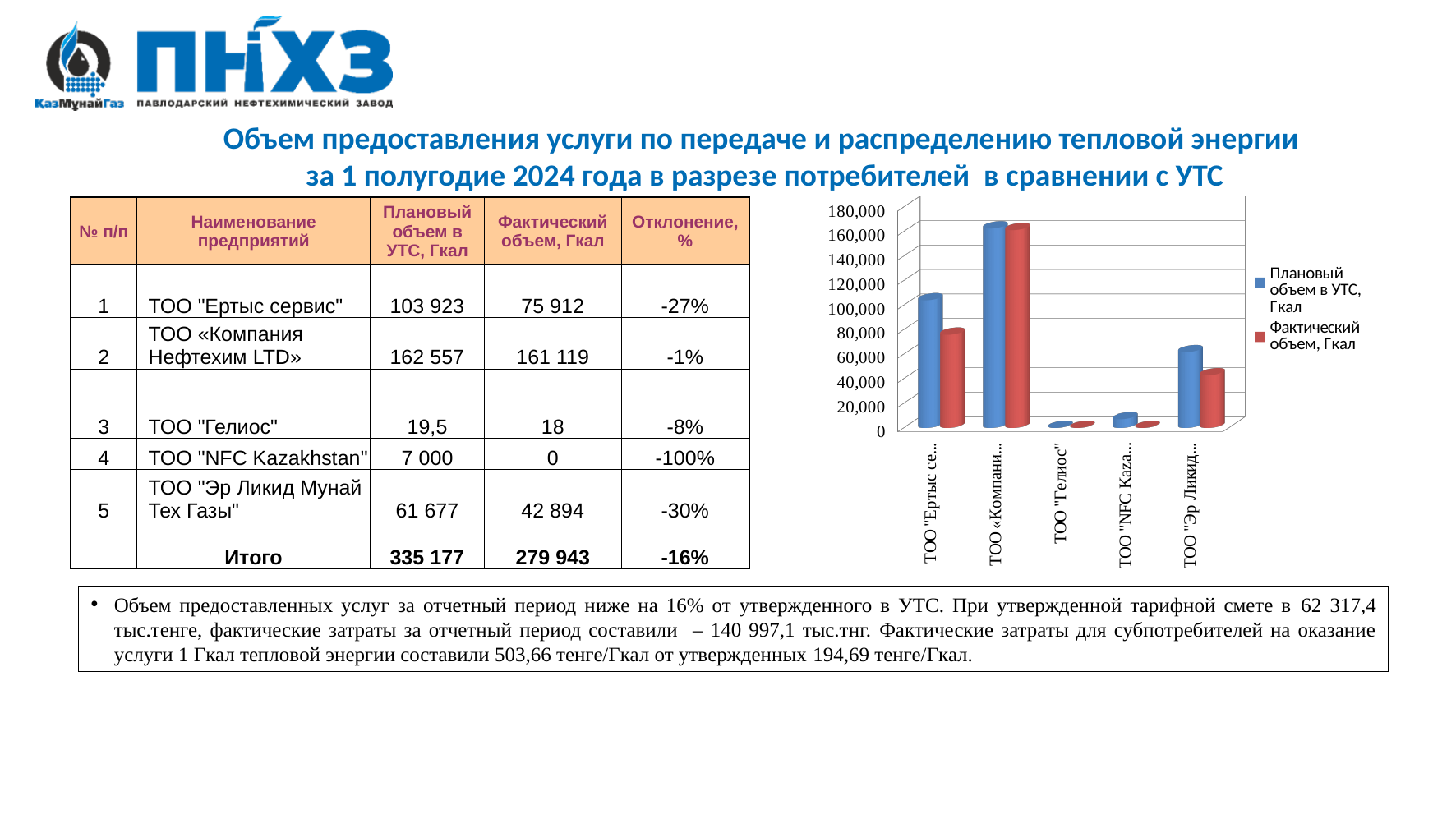
Which company has the lowest actual volume (Фактический объем) in the chart? ТОО "NFC Kazakhstan" Is the actual volume bar for ТОО "Эр Ликид Мунай Тех Газы" greater or less than 60,000? less How many series does the chart legend list? 2 According to the table on the slide, what is the planned volume in УТС for ТОО "Гелиос", Гкал? 19,5 How many companies (categories) are plotted on the x axis of the chart? 5 Which company has the highest planned volume (Плановый объем в УТС) in the chart? ТОО «Компания Нефтехим LTD» According to the table on the slide, what is the actual volume for ТОО "Эр Ликид Мунай Тех Газы", Гкал? 42 894 Using the values printed in the table, what is the difference between the planned and actual volume for ТОО "Ертыс сервис", Гкал? 28 011 Is the planned volume bar for ТОО "Ертыс сервис" greater or less than 80,000? greater For ТОО "Ертыс сервис", which is larger: the planned volume or the actual volume? planned volume What colour represents the series "Фактический объем, Гкал" in the chart? red What kind of chart is shown on the slide? bar chart